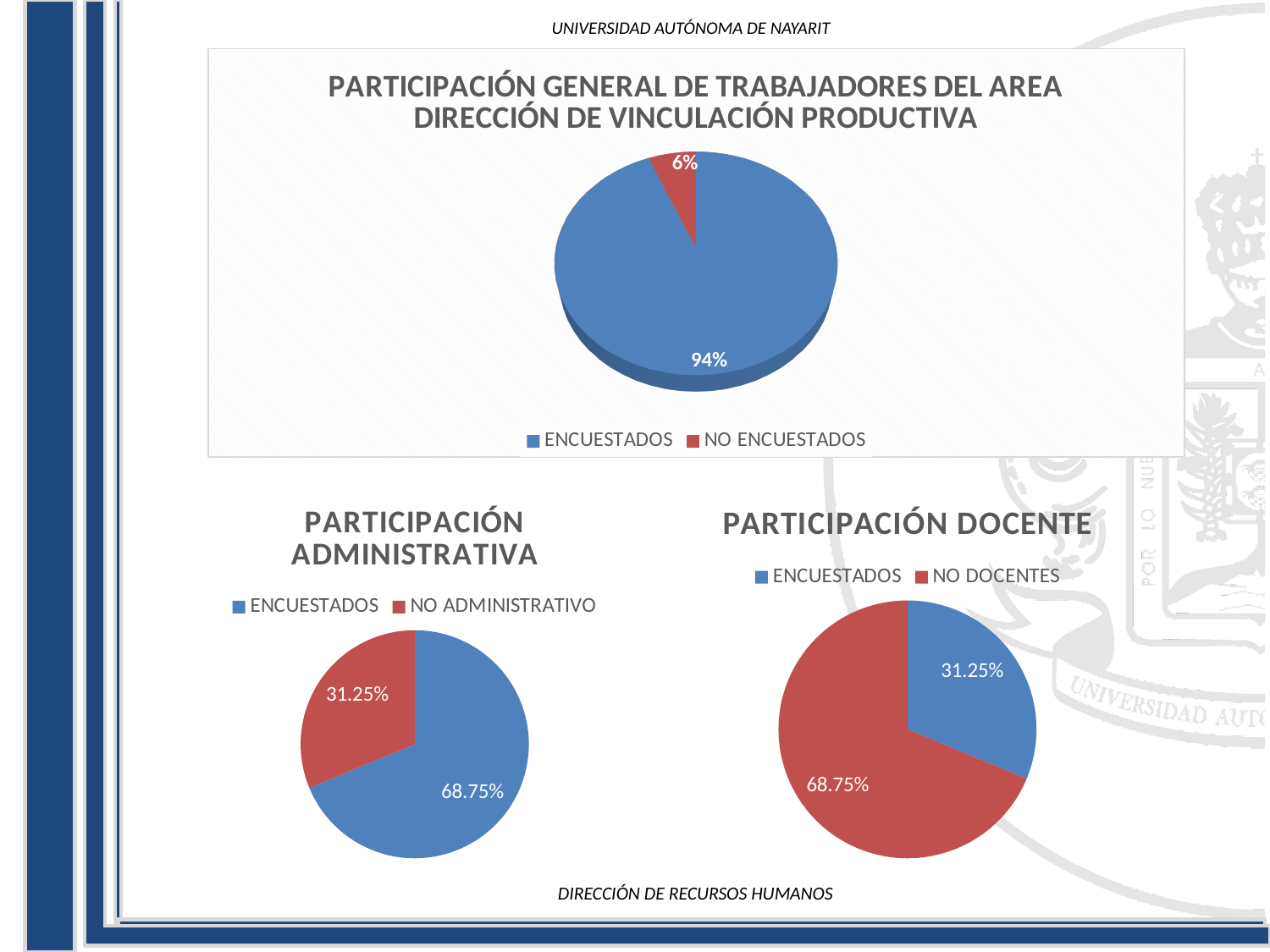
In the chart titled 'PARTICIPACIÓN ADMINISTRATIVA', which slice is the smallest? NO ADMINISTRATIVO How many entries does the legend of the chart titled 'PARTICIPACIÓN DOCENTE' list? 2 What kind of chart is the chart titled 'PARTICIPACIÓN ADMINISTRATIVA'? Pie chart In the chart titled 'PARTICIPACIÓN ADMINISTRATIVA', what share of the pie is NO ADMINISTRATIVO? 31.25% In the chart titled 'PARTICIPACIÓN GENERAL DE TRABAJADORES DEL AREA DIRECCIÓN DE VINCULACIÓN PRODUCTIVA', what share of the pie is NO ENCUESTADOS? 6% In the chart titled 'PARTICIPACIÓN GENERAL DE TRABAJADORES DEL AREA DIRECCIÓN DE VINCULACIÓN PRODUCTIVA', what is the difference between the ENCUESTADOS and NO ENCUESTADOS shares? 88% In the chart titled 'PARTICIPACIÓN GENERAL DE TRABAJADORES DEL AREA DIRECCIÓN DE VINCULACIÓN PRODUCTIVA', what share of the pie is ENCUESTADOS? 94% In the chart titled 'PARTICIPACIÓN DOCENTE', which is larger, ENCUESTADOS or NO DOCENTES? NO DOCENTES In the chart titled 'PARTICIPACIÓN GENERAL DE TRABAJADORES DEL AREA DIRECCIÓN DE VINCULACIÓN PRODUCTIVA', which slice is the largest? ENCUESTADOS